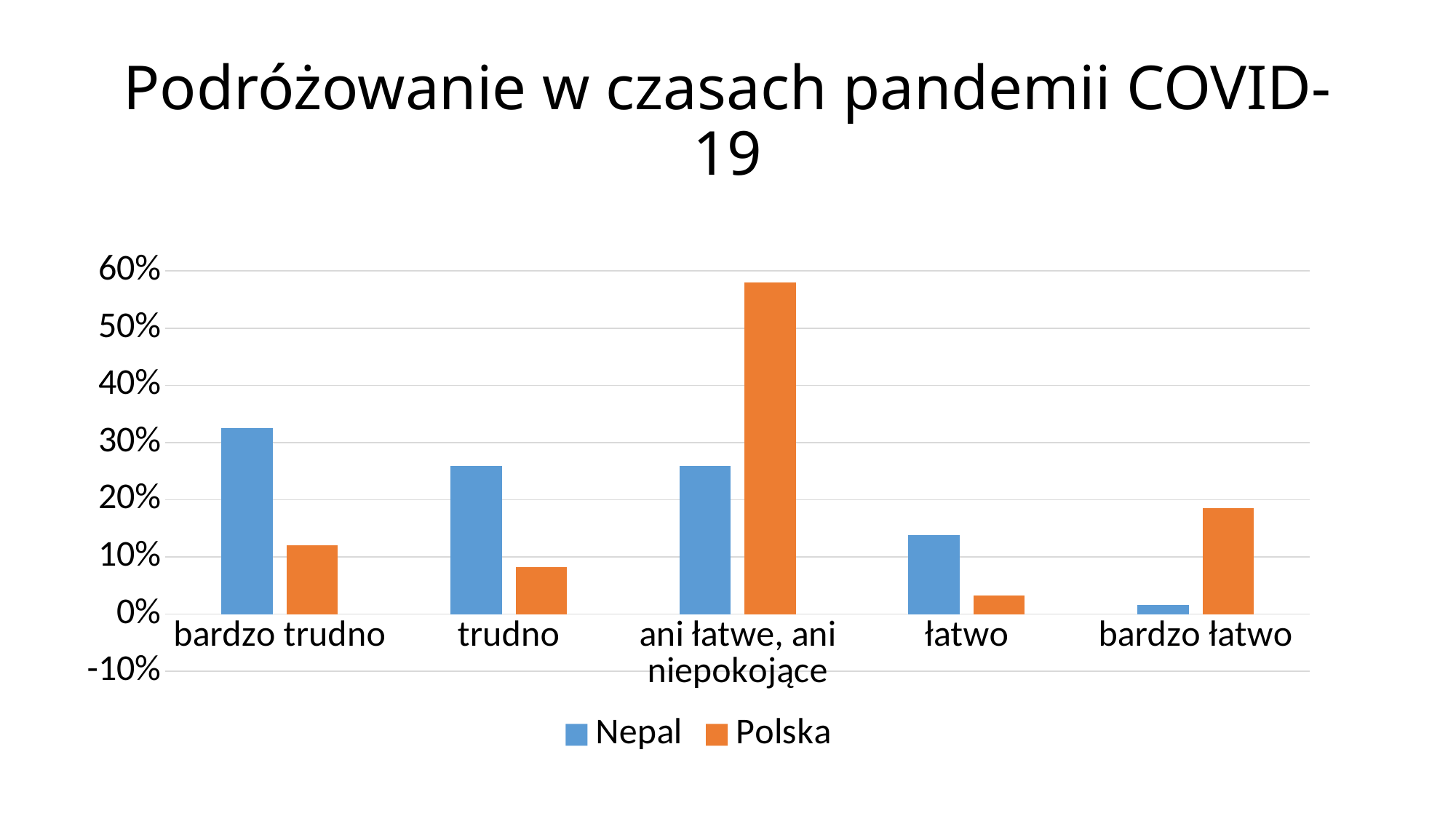
How many categories are shown on the x axis? 5 How many series does the legend list? 2 What is the title of the chart? Podróżowanie w czasach pandemii COVID-19 For the category 'bardzo łatwo', which series has the larger value, Nepal or Polska? Polska Is the value for Polska in the category 'trudno' greater or less than 10%? less Is the value for Nepal in the category 'bardzo trudno' greater or less than 30%? greater What kind of chart is shown on the slide? bar chart Which category has the highest value for Nepal? bardzo trudno Which category has the lowest value for Nepal? bardzo łatwo Which category has the lowest value for Polska? łatwo Is the value for Polska in the category 'ani łatwe, ani niepokojące' greater or less than 50%? greater Which category has the highest value for Polska? ani łatwe, ani niepokojące